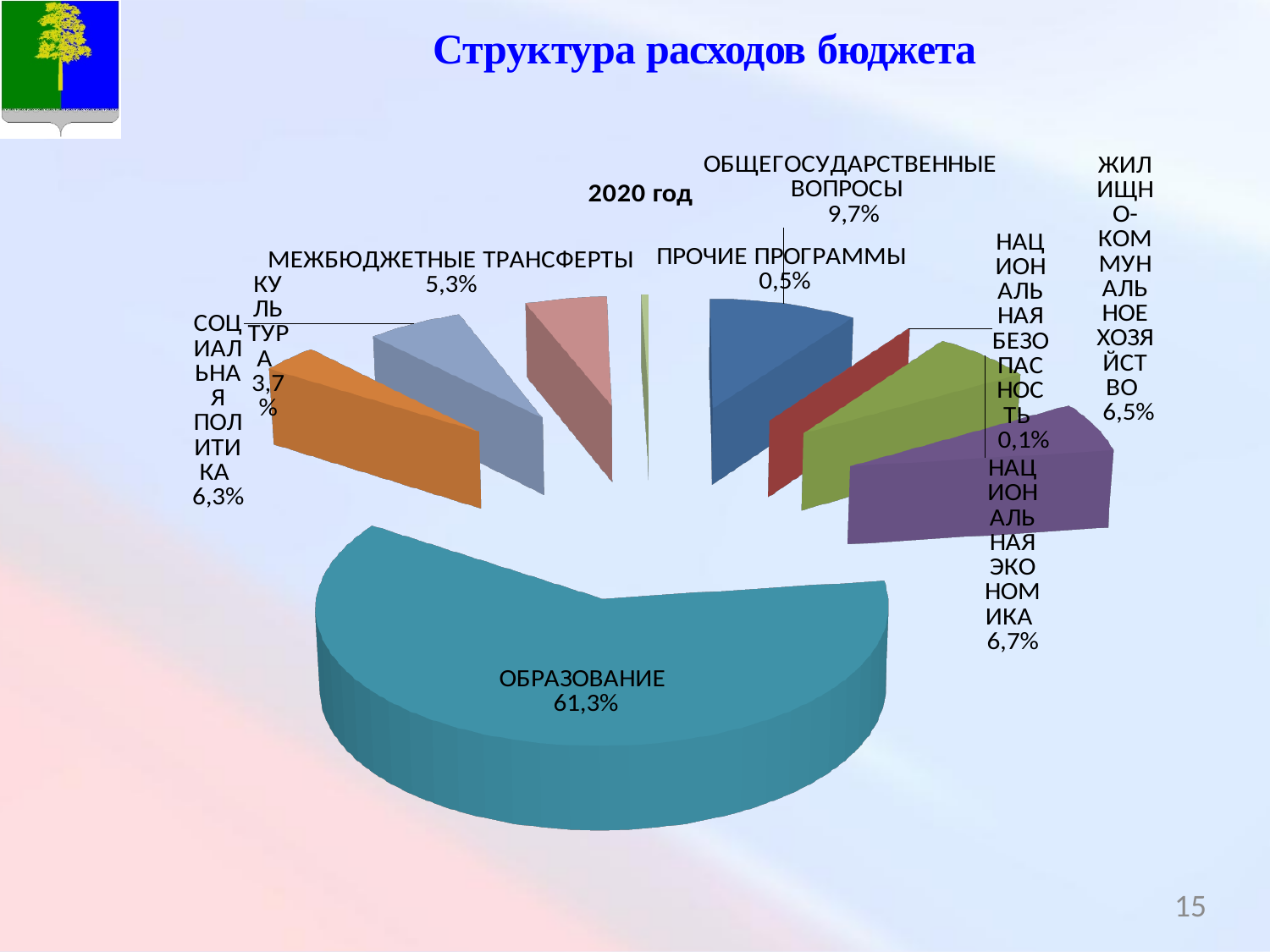
What is the value for НАЦИОНАЛЬНАЯ ЭКОНОМИКА? 6,7% Which category has the largest share of the pie? ОБРАЗОВАНИЕ What share of budget expenditure does ОБРАЗОВАНИЕ account for? 61,3% What kind of chart is shown on the slide? pie chart Which category has the smallest share of the pie? НАЦИОНАЛЬНАЯ БЕЗОПАСНОСТЬ Which is larger, the share of СОЦИАЛЬНАЯ ПОЛИТИКА or the share of МЕЖБЮДЖЕТНЫЕ ТРАНСФЕРТЫ? СОЦИАЛЬНАЯ ПОЛИТИКА What percentage is shown for МЕЖБЮДЖЕТНЫЕ ТРАНСФЕРТЫ? 5,3% What is the difference between the shares of ОБРАЗОВАНИЕ and ОБЩЕГОСУДАРСТВЕННЫЕ ВОПРОСЫ? 51,6% What is the value shown for ОБЩЕГОСУДАРСТВЕННЫЕ ВОПРОСЫ? 9,7% What share is shown for КУЛЬТУРА? 3,7% What is the title of the chart on the slide? 2020 год How many slices does the pie chart have? 9